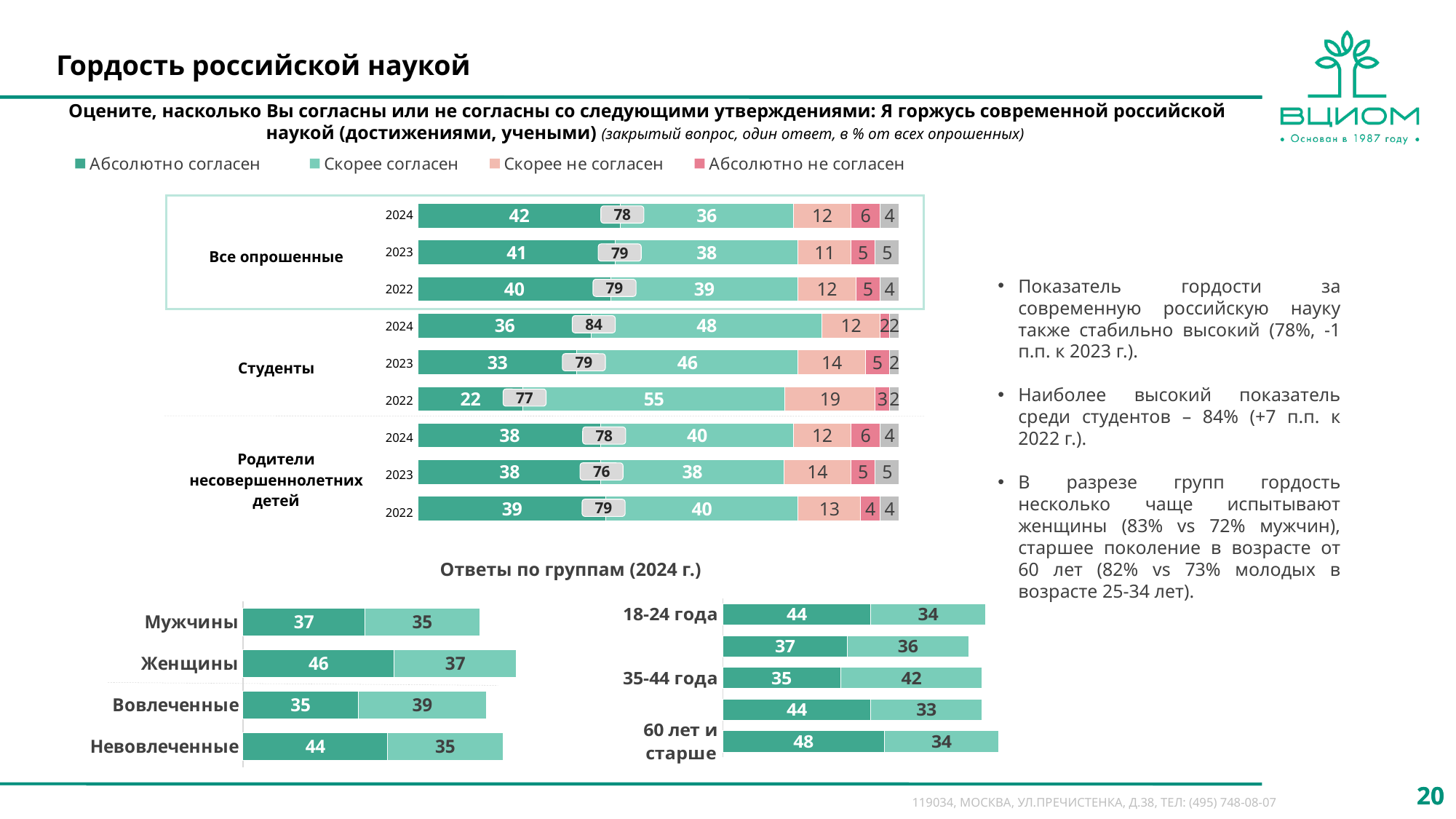
In the top stacked bar chart, in which year is the «Абсолютно согласен» value for «Студенты» the highest? 2024 In the top stacked bar chart, in which year is the «Абсолютно согласен» value for «Студенты» the lowest? 2022 In the top stacked bar chart, what is the difference between «Абсолютно согласен» and «Скорее согласен» for «Все опрошенные» in 2024? 6 In the bottom-left chart «Ответы по группам (2024 г.)», which has the larger «Абсолютно согласен» value: «Мужчины» or «Женщины»? Женщины In the bottom-right chart «Ответы по группам (2024 г.)», what is the «Абсолютно согласен» value for «60 лет и старше»? 48 How many series does the legend of the top stacked bar chart list? 4 In the top stacked bar chart, what is the value for «Абсолютно согласен» among «Все опрошенные» in 2024? 42 In the bottom-left chart «Ответы по группам (2024 г.)», what is the «Абсолютно согласен» value for «Женщины»? 46 In the bottom-left chart «Ответы по группам (2024 г.)», what is the total of the two segments for «Женщины»? 83 What kind of chart is the top chart on the slide? Stacked bar chart In the top stacked bar chart, what is the value for «Скорее согласен» among «Студенты» in 2022? 55 In the top stacked bar chart, what is the value for «Скорее не согласен» among «Родители несовершеннолетних детей» in 2023? 14